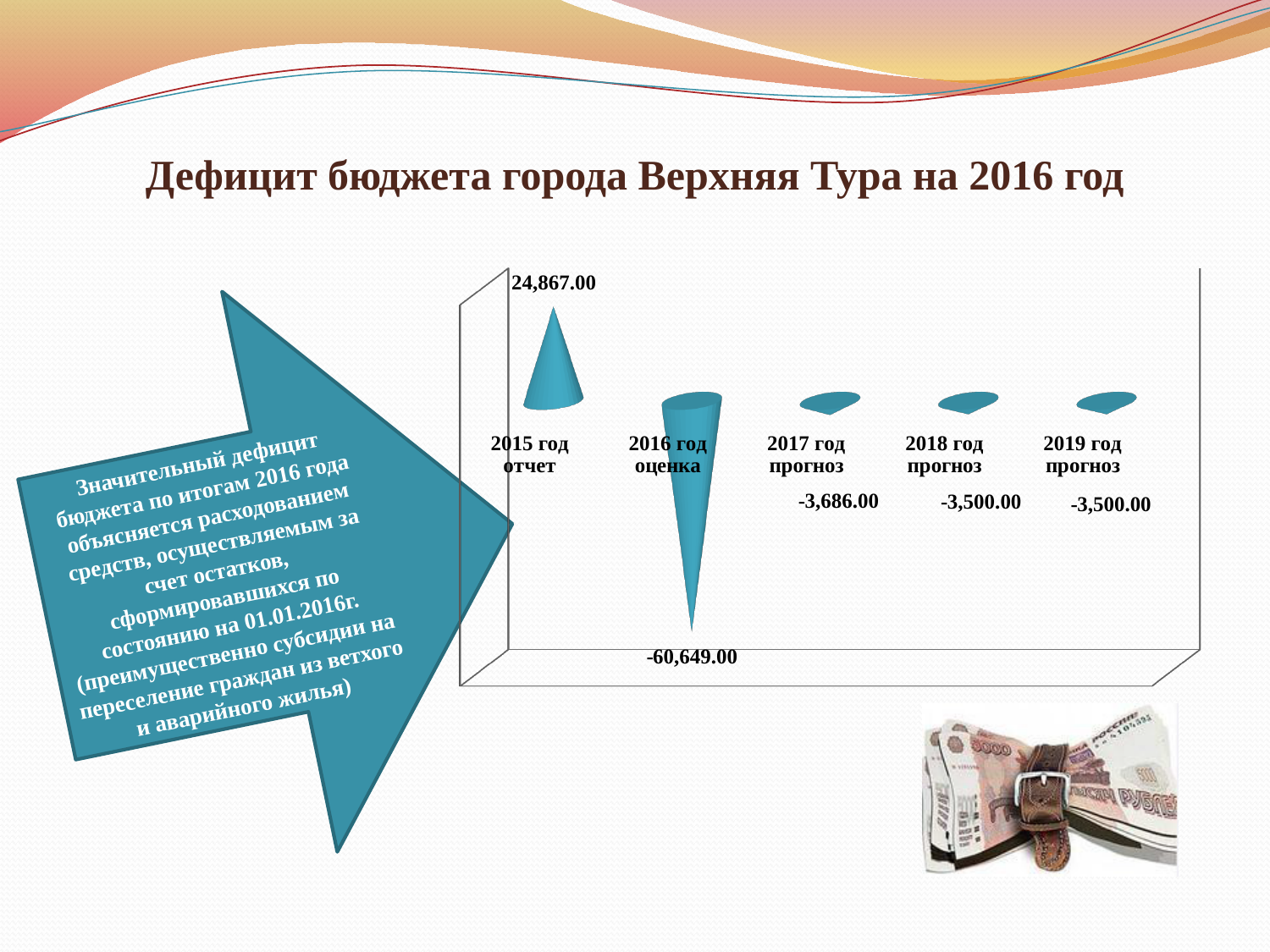
What is the difference between the values for 2017 год прогноз and 2018 год прогноз? 186.00 What is the value for 2015 год отчет? 24,867.00 Which category has the highest value? 2015 год отчет What is the difference between the values for 2015 год отчет and 2016 год оценка? 85,516.00 What is the value for 2019 год прогноз? -3,500.00 What is the title of the slide containing the chart? Дефицит бюджета города Верхняя Тура на 2016 год What is the value for 2017 год прогноз? -3,686.00 Which category has the lowest value? 2016 год оценка Which is larger, the value for 2017 год прогноз or the value for 2018 год прогноз? 2018 год прогноз What is the value for 2018 год прогноз? -3,500.00 What is the value for 2016 год оценка? -60,649.00 How many categories are shown in the chart? 5